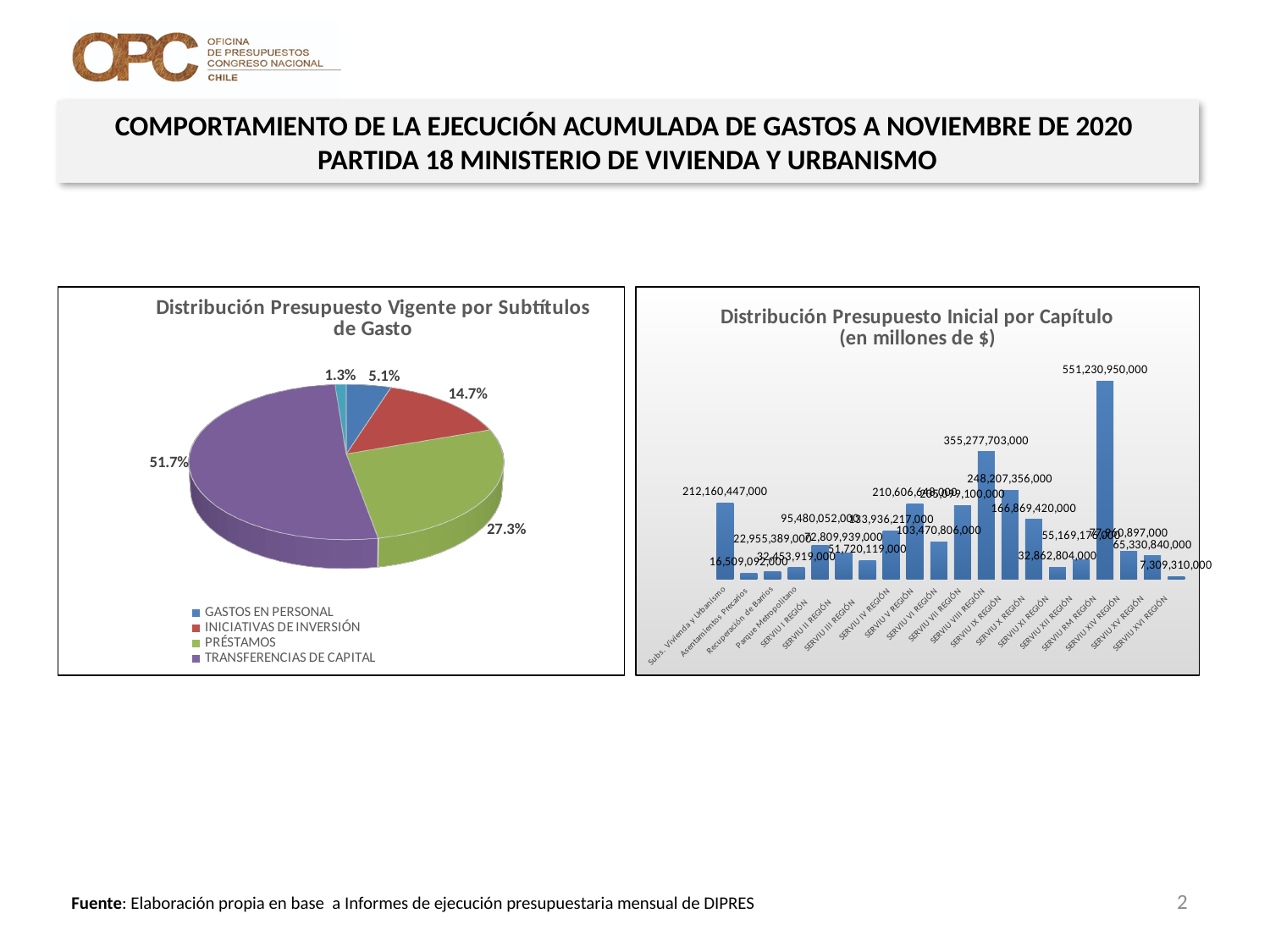
In the right bar chart, what is the value for Subs. Vivienda y Urbanismo? 212,160,447,000 In the left pie chart, what share does INICIATIVAS DE INVERSIÓN have? 14.7% In the right bar chart, which category has the highest value? SERVIU RM REGIÓN In the left pie chart, what share does PRÉSTAMOS have? 27.3% In the left pie chart, by how many percentage points does TRANSFERENCIAS DE CAPITAL exceed PRÉSTAMOS? 24.4 percentage points What kind of chart is the left chart, 'Distribución Presupuesto Vigente por Subtítulos de Gasto'? Pie chart In the left pie chart, which legend category has the largest slice? TRANSFERENCIAS DE CAPITAL In the left pie chart, what share does TRANSFERENCIAS DE CAPITAL have? 51.7% In the right bar chart, what is the value of the tallest bar? 551,230,950,000 In the right bar chart, which is larger: Subs. Vivienda y Urbanismo or Asentamientos Precarios? Subs. Vivienda y Urbanismo In the left pie chart, how many entries does the legend list? 4 What kind of chart is the right chart, 'Distribución Presupuesto Inicial por Capítulo'? Bar chart